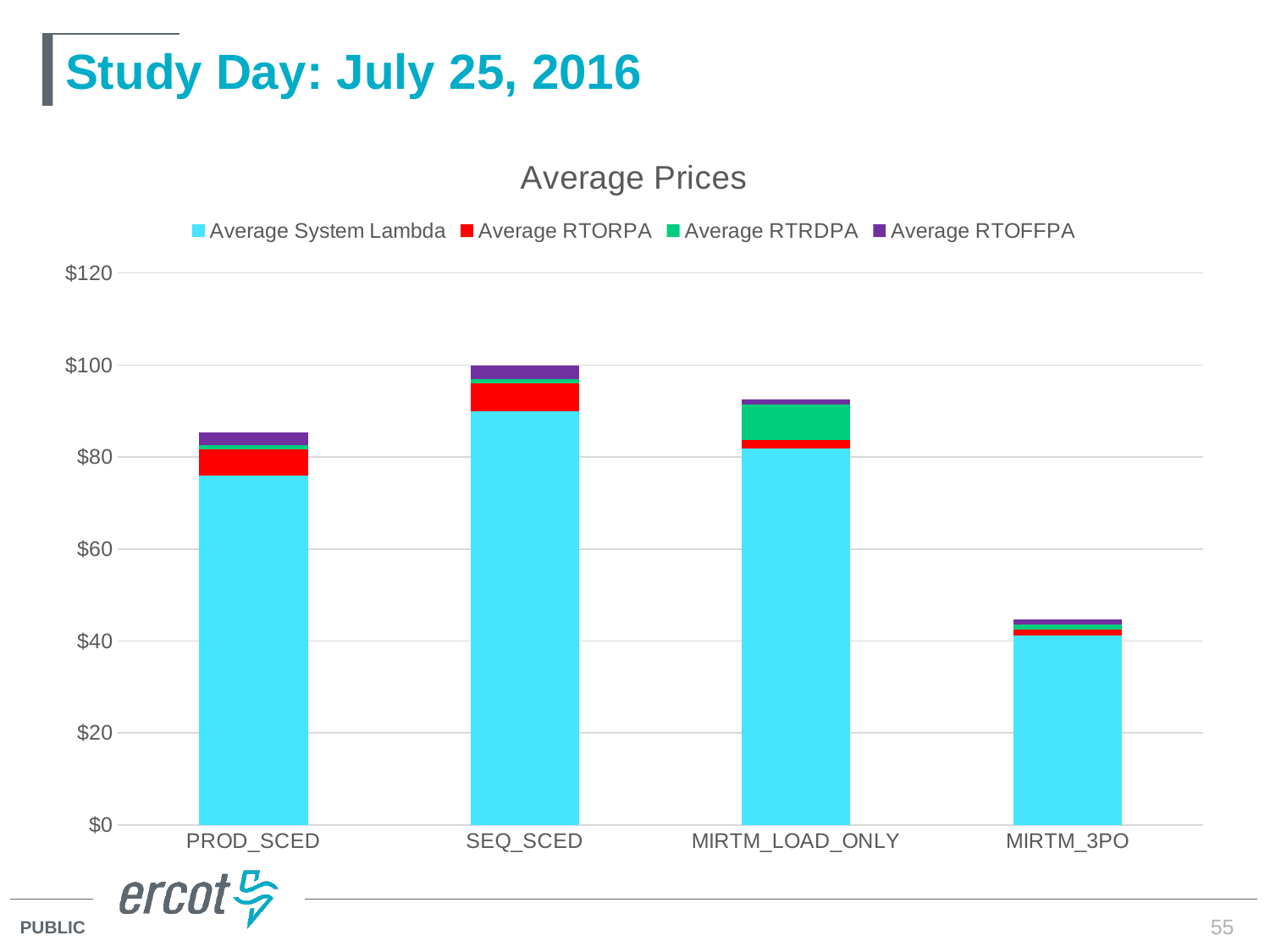
How many series does the legend list? 4 Which category has the tallest stacked bar overall? SEQ_SCED Is the total stacked value for MIRTM_LOAD_ONLY greater or less than $100? less What is the title of the chart? Average Prices How many categories are shown on the x axis? 4 Which category has the shortest stacked bar overall? MIRTM_3PO Is the Average System Lambda value for SEQ_SCED greater or less than $80? greater Is the total stacked value for MIRTM_3PO greater or less than $40? greater Which has the larger total stacked bar, PROD_SCED or MIRTM_LOAD_ONLY? MIRTM_LOAD_ONLY Which category has the largest Average RTRDPA segment? MIRTM_LOAD_ONLY What type of chart is shown on the slide? Stacked bar chart